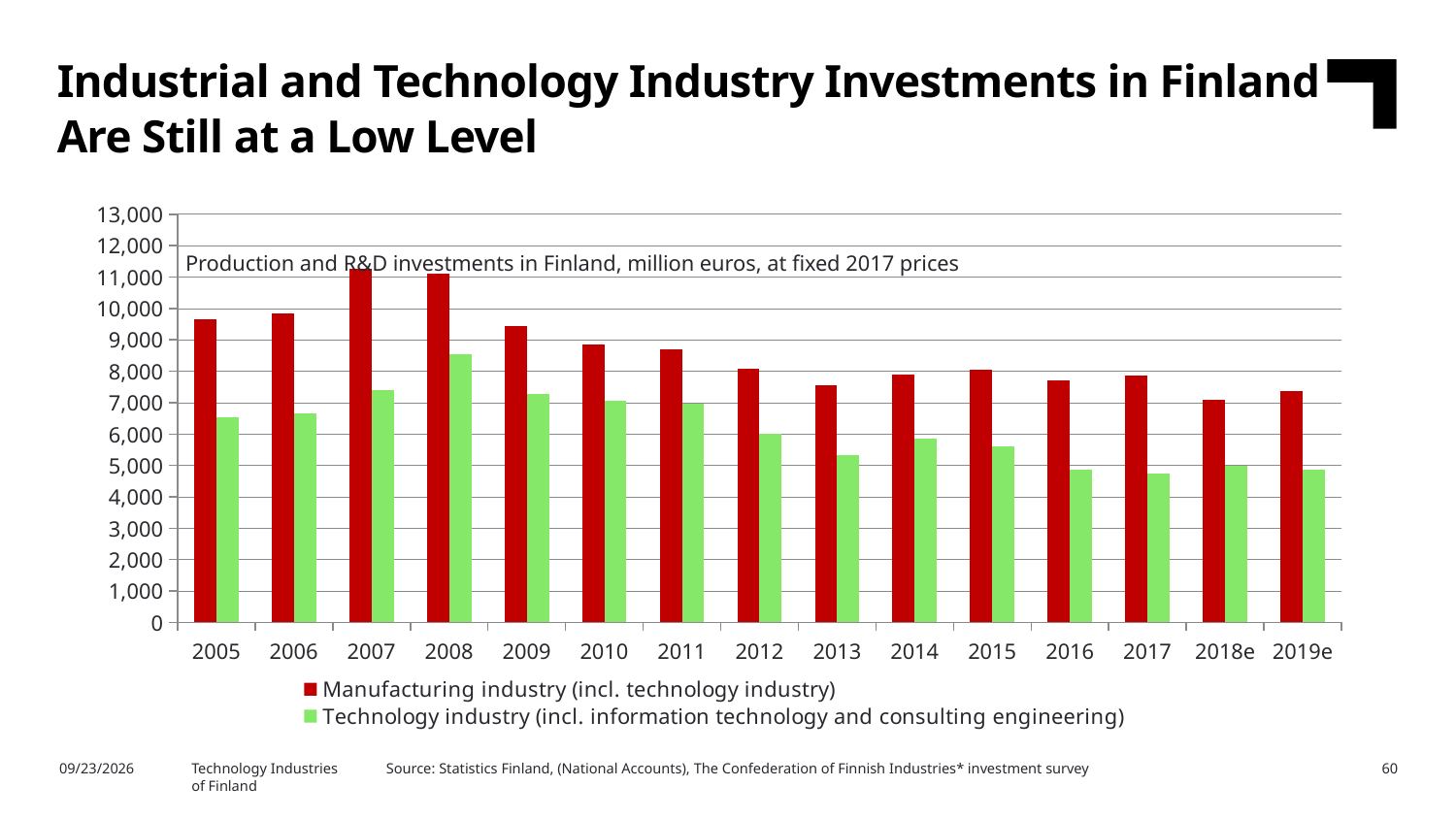
How many years (categories) are shown on the x axis? 15 How many series does the legend list? 2 Which is larger in 2005: the Manufacturing industry value or the Technology industry value? Manufacturing industry Is the Manufacturing industry value for 2007 greater or less than 11,000? greater Is the Technology industry value for 2017 greater or less than 5,000? less In which year is the Technology industry value highest? 2008 What kind of chart is shown on the slide? bar chart Does the Manufacturing industry value rise or fall from 2008 to 2013? fall Which colour represents the Technology industry series? green In which year is the Manufacturing industry value lowest? 2018e Is the Manufacturing industry value for 2013 greater or less than 8,000? less